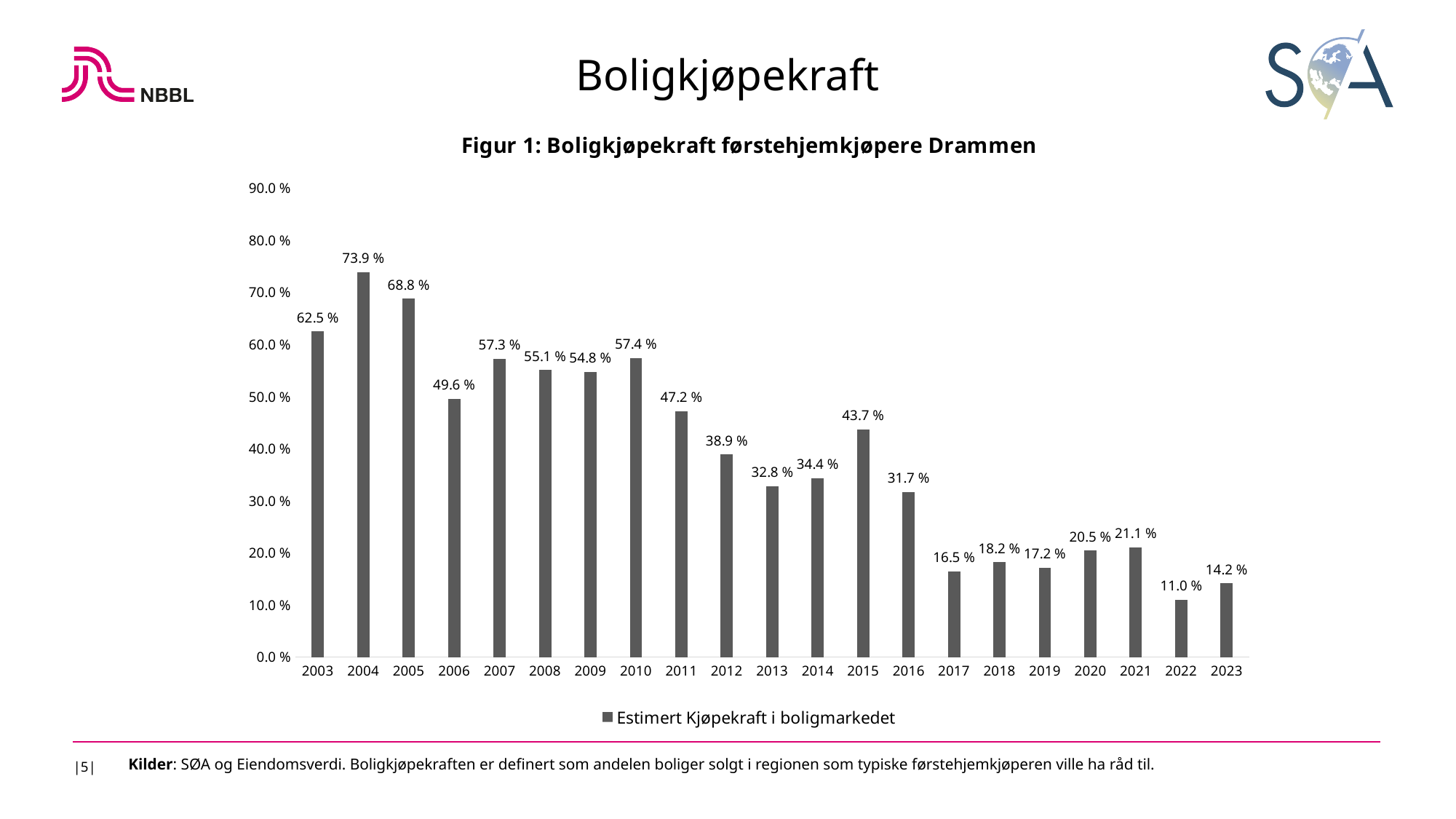
How many years are shown on the x axis? 21 How many series does the legend list? 1 What value is shown for 2023? 14.2 % What is the title of the figure? Figur 1: Boligkjøpekraft førstehjemkjøpere Drammen Overall, do the values rise or fall from 2003 to 2023? Fall What is the estimated housing purchasing power for first-time buyers in Drammen in 2004? 73.9 % Which year has the larger value, 2012 or 2015? 2015 Which year has the lowest value in the chart? 2022 What value is shown for 2015? 43.7 % What type of chart is shown on the slide? Bar chart What is the difference in percentage points between the 2004 value and the 2023 value? 59.7 percentage points Which year has the highest value in the chart? 2004